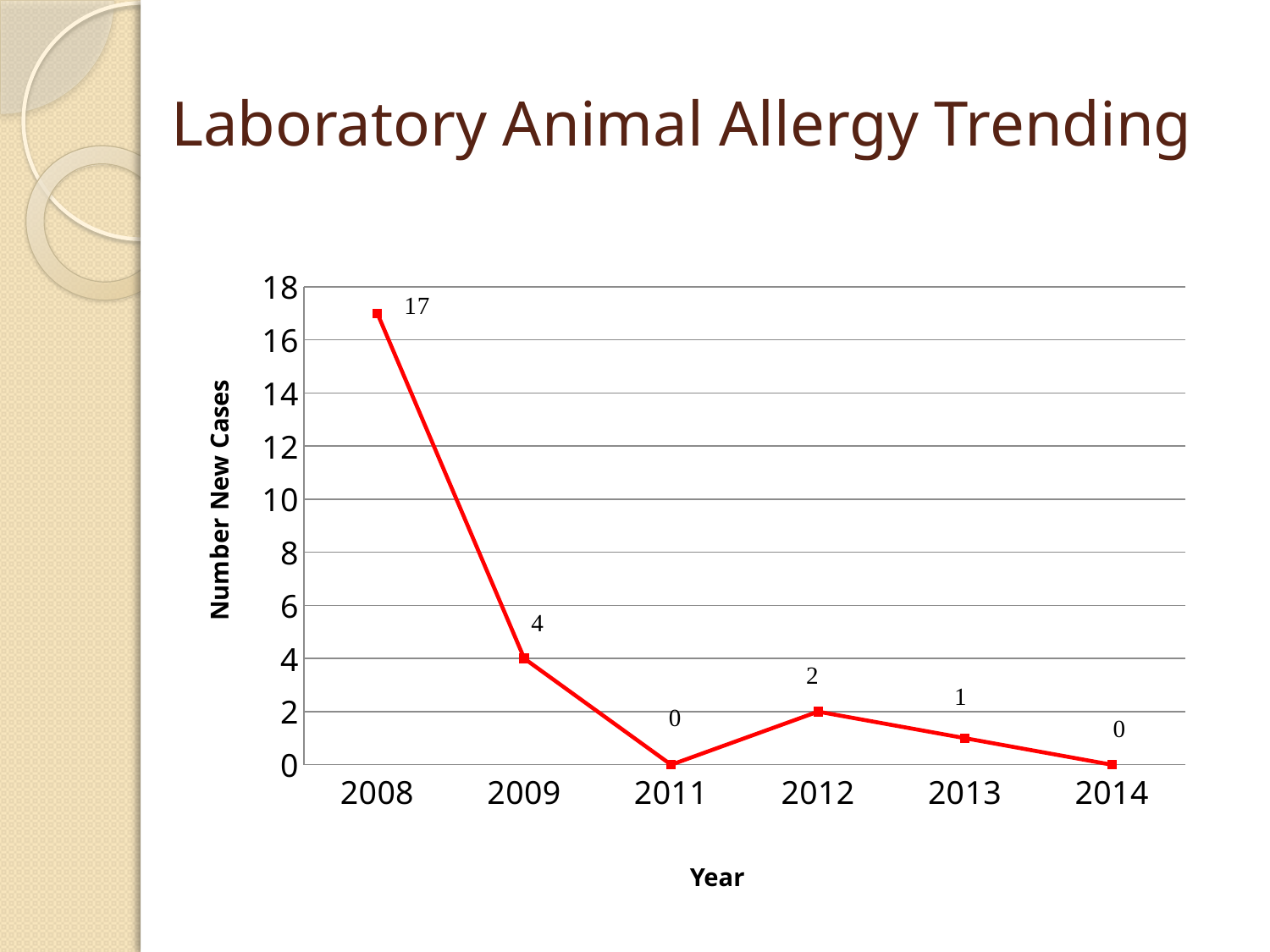
Which year has more new cases, 2009 or 2012? 2009 Is the value for 2008 greater or less than 16? greater How many years are plotted on the x axis? 6 What is the number of new cases in 2013? 1 What is the number of new cases in 2008? 17 What is the number of new cases in 2012? 2 What is the label of the y axis? Number New Cases What kind of chart is shown on the slide? line chart What is the number of new cases in 2009? 4 What is the difference in new cases between 2008 and 2009? 13 What is the difference in new cases between 2012 and 2013? 1 Which year has the highest number of new cases? 2008